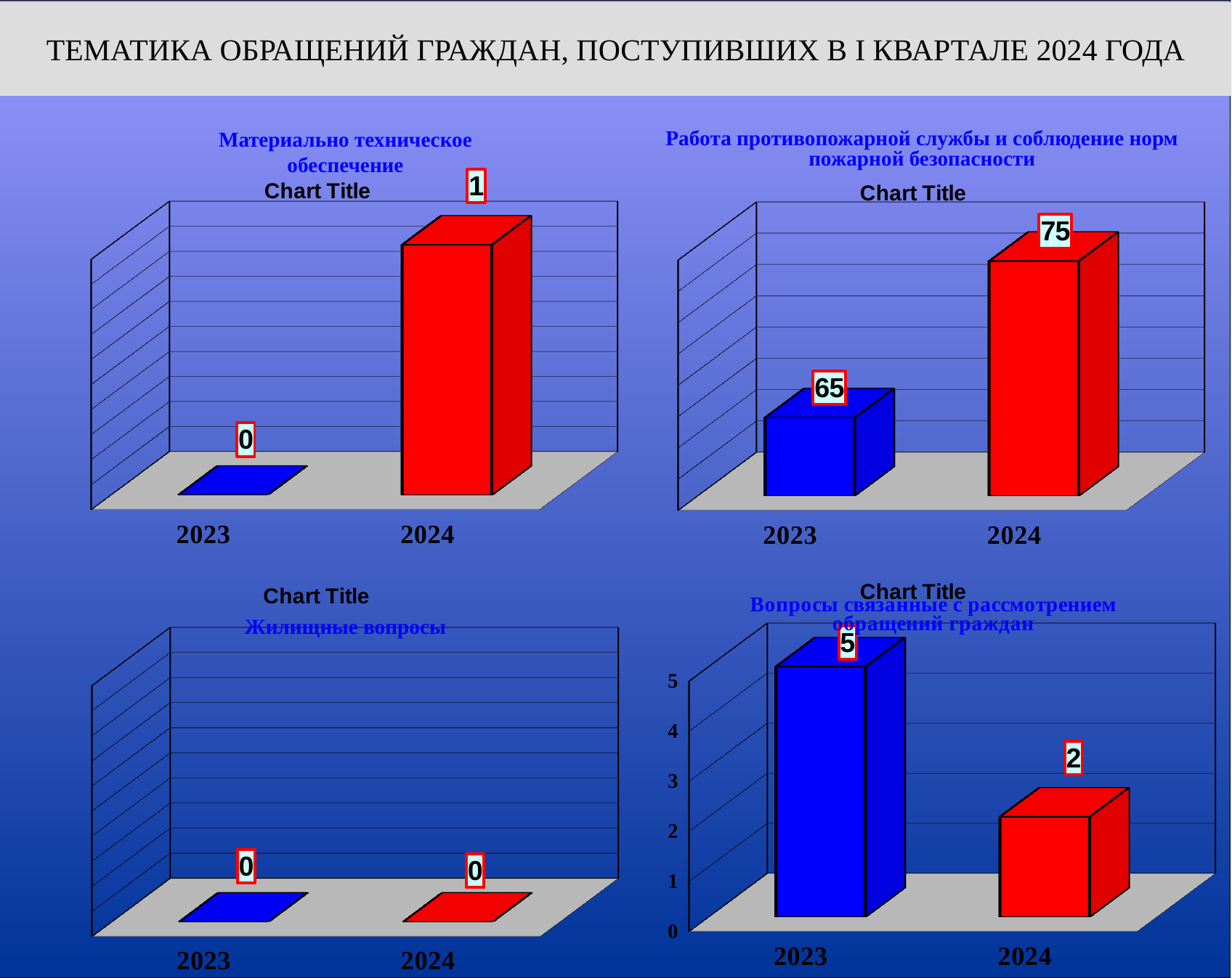
In the bottom-right chart (Вопросы связанные с рассмотрением обращений граждан), do the values rise or fall from 2023 to 2024? fall What kind of chart is the bottom-right chart (Вопросы связанные с рассмотрением обращений граждан)? bar chart In the top-right chart (Работа противопожарной службы), what is the difference between the 2024 and 2023 values? 10 In the top-right chart (Работа противопожарной службы), which year has the higher value? 2024 In the bottom-left chart (Жилищные вопросы), what is the value for 2024? 0 In the top-left chart (Материально техническое обеспечение), what is the value for 2023? 0 In the bottom-right chart (Вопросы связанные с рассмотрением обращений граждан), what is the value for 2023? 5 In the bottom-right chart (Вопросы связанные с рассмотрением обращений граждан), what is the value for 2024? 2 In the top-left chart (Материально техническое обеспечение), what is the value for 2024? 1 In the top-right chart (Работа противопожарной службы и соблюдение норм пожарной безопасности), what is the value for 2024? 75 How many categories are shown on the x axis of the top-left chart (Материально техническое обеспечение)? 2 In the top-right chart (Работа противопожарной службы и соблюдение норм пожарной безопасности), what is the value for 2023? 65